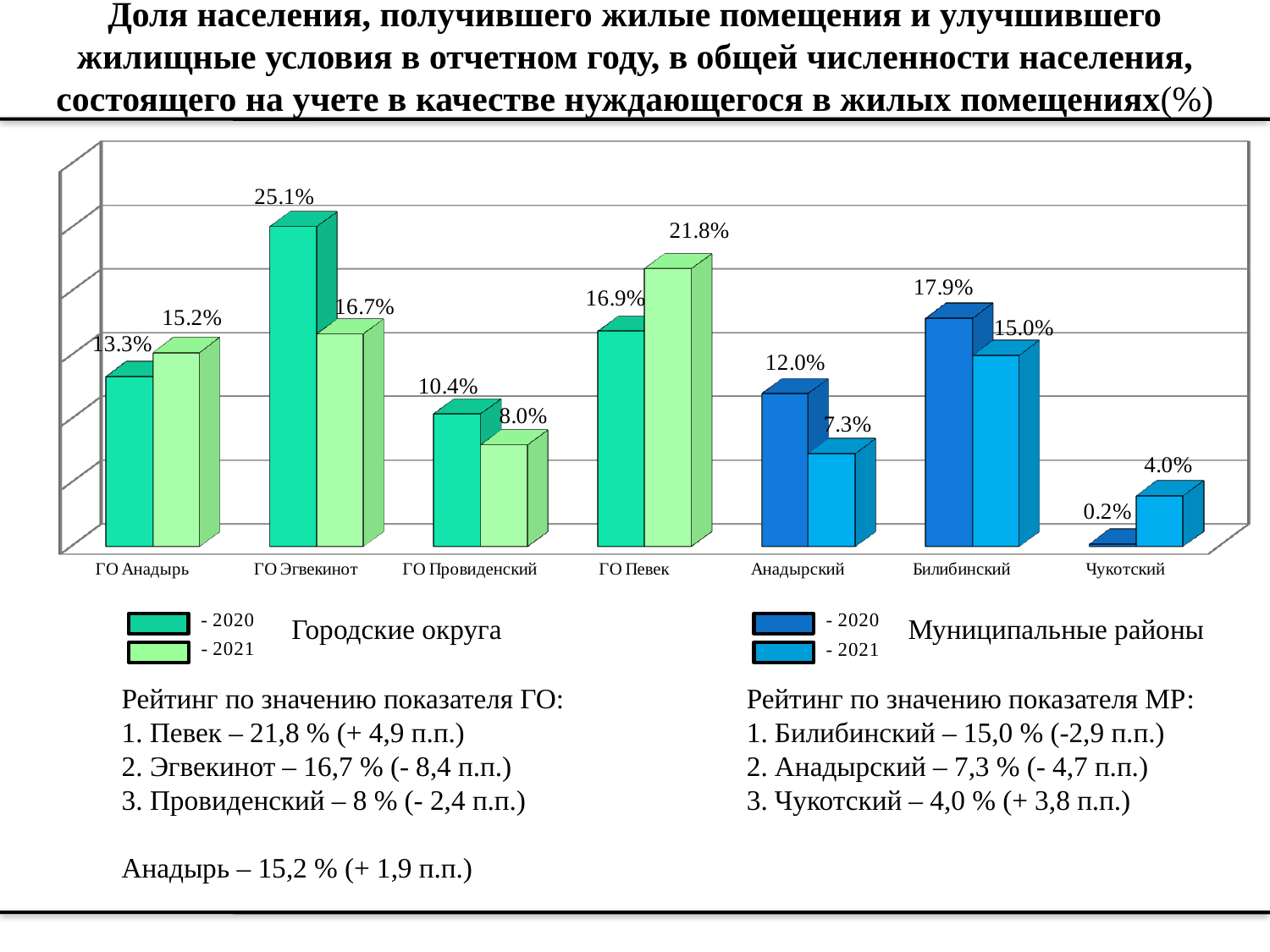
What kind of chart is shown on the slide? Bar chart What is the 2020 value for Билибинский? 17.9% How many categories are shown on the x axis of the chart? 7 How many years (series) does the legend list for each group? 2 What is the 2021 value for Чукотский? 4.0% What is the difference between the 2020 and 2021 values for Анадырский? 4.7 percentage points Which is larger for ГО Анадырь, the 2020 value or the 2021 value? 2021 Which category has the highest 2020 value? ГО Эгвекинот What is the 2021 value for ГО Певек? 21.8% What is the difference between the 2020 and 2021 values for ГО Эгвекинот? 8.4 percentage points Which category has the lowest 2021 value? Чукотский Which is larger, the 2021 value for ГО Певек or the 2021 value for Билибинский? ГО Певек